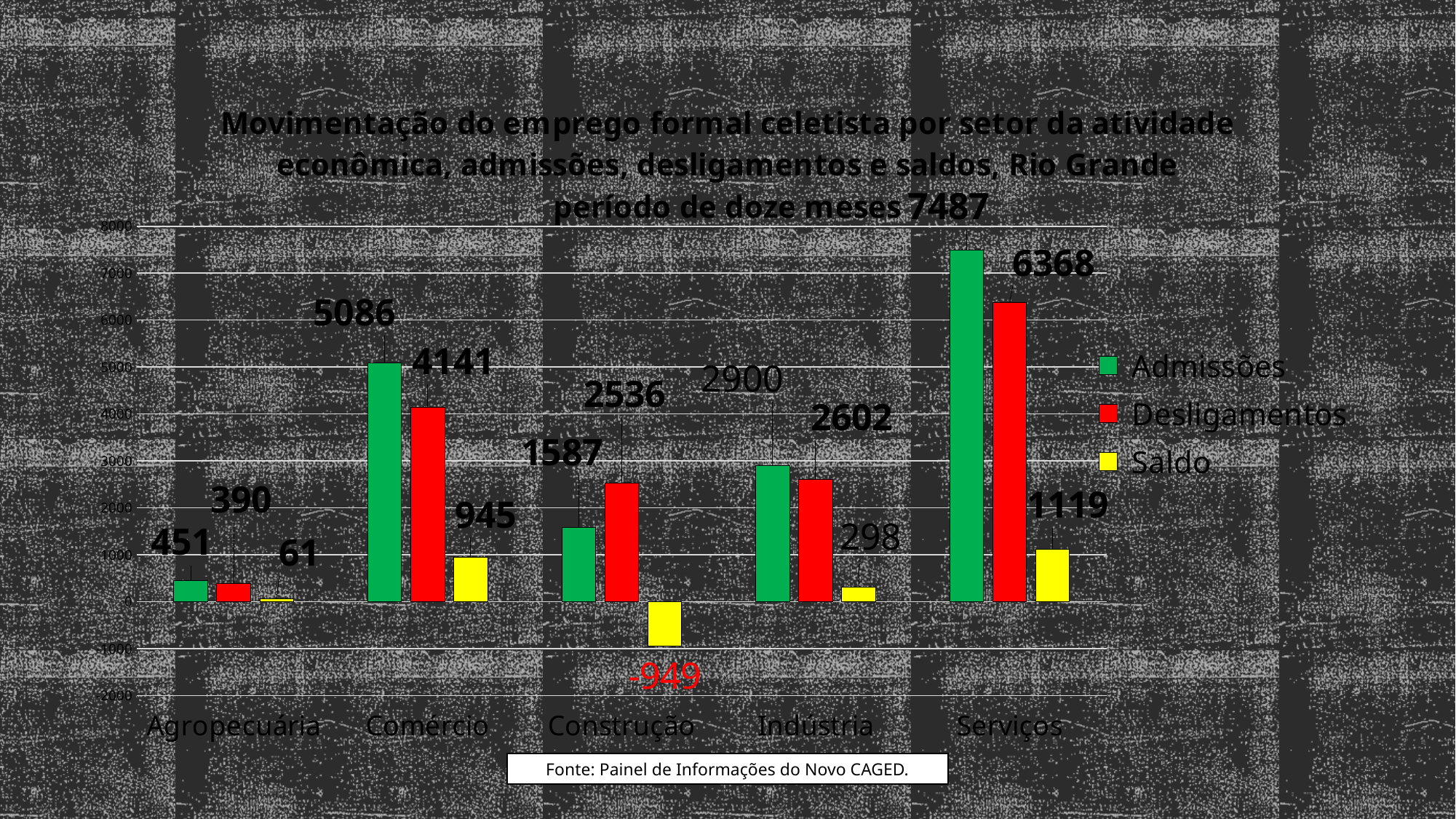
Which is larger for Construção, Admissões or Desligamentos? Desligamentos What is the Desligamentos value for Comércio? 4141 Which sector has the lowest Saldo value? Construção What is the Admissões value for Indústria? 2900 Which colour represents the Saldo series in the legend? Yellow How many sectors are shown on the x axis? 5 What is the Admissões value for Serviços? 7487 What is the Saldo value for Construção? -949 What is the difference between Admissões and Desligamentos for Comércio? 945 How many series does the legend list? 3 Which sector has the highest Admissões value? Serviços What kind of chart is shown on the slide? Bar chart